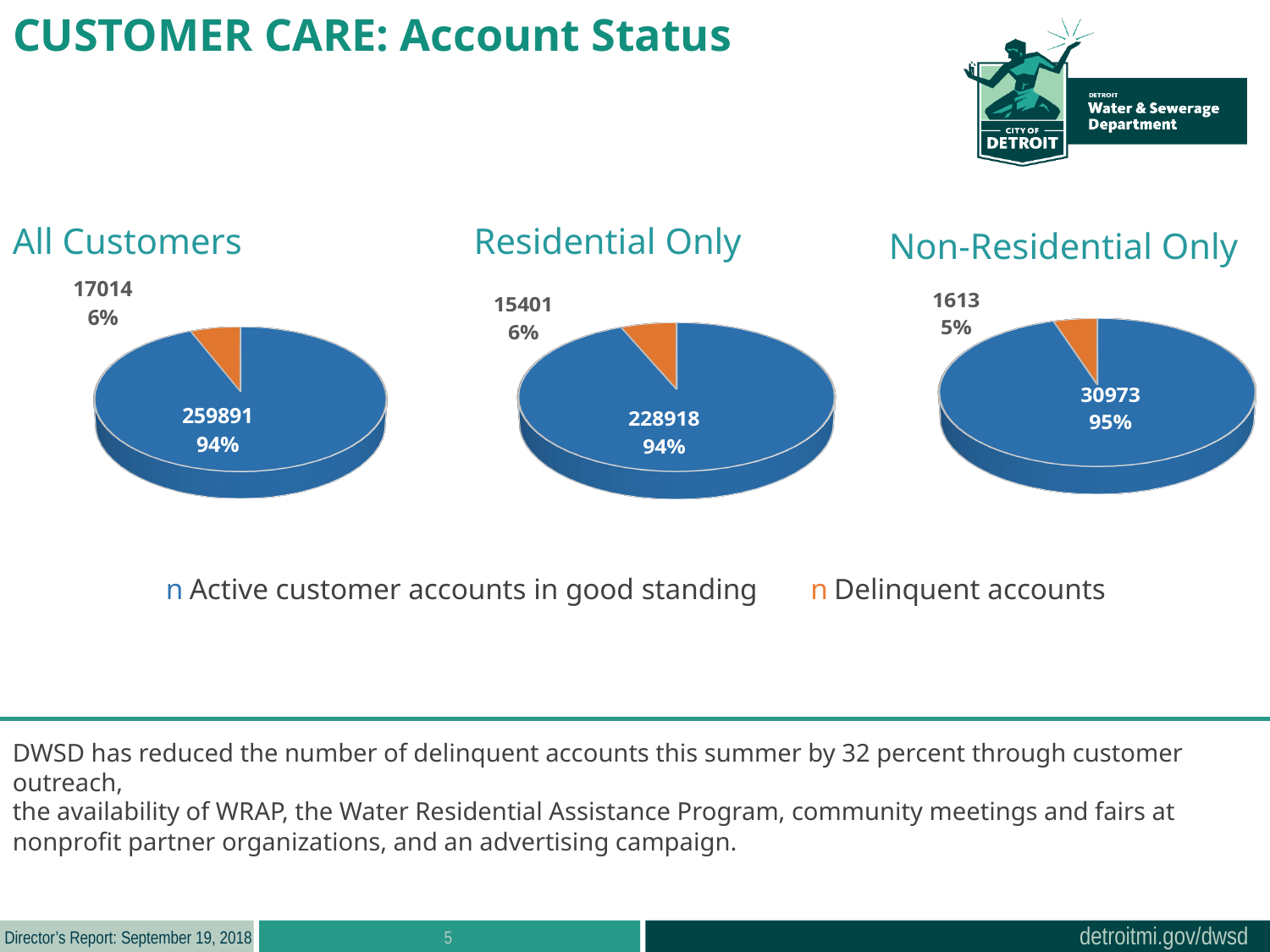
How many entries does the legend list? 2 In the Residential Only chart, how many delinquent accounts are there? 15401 How many slices does the Residential Only chart have? 2 In the All Customers chart, which slice is larger: active customer accounts in good standing or delinquent accounts? Active customer accounts in good standing In the Non-Residential Only chart, how many active customer accounts are in good standing? 30973 In the Non-Residential Only chart, what share of accounts are delinquent? 5% In the Residential Only chart, what is the difference between the number of active accounts in good standing and the number of delinquent accounts? 213517 What kind of chart is used for the All Customers data? Pie chart In the All Customers chart, how many delinquent accounts are there? 17014 In the All Customers chart, how many active customer accounts are in good standing? 259891 In the Non-Residential Only chart, what is the total number of accounts shown? 32586 In the Residential Only chart, what share of accounts are active customer accounts in good standing? 94%